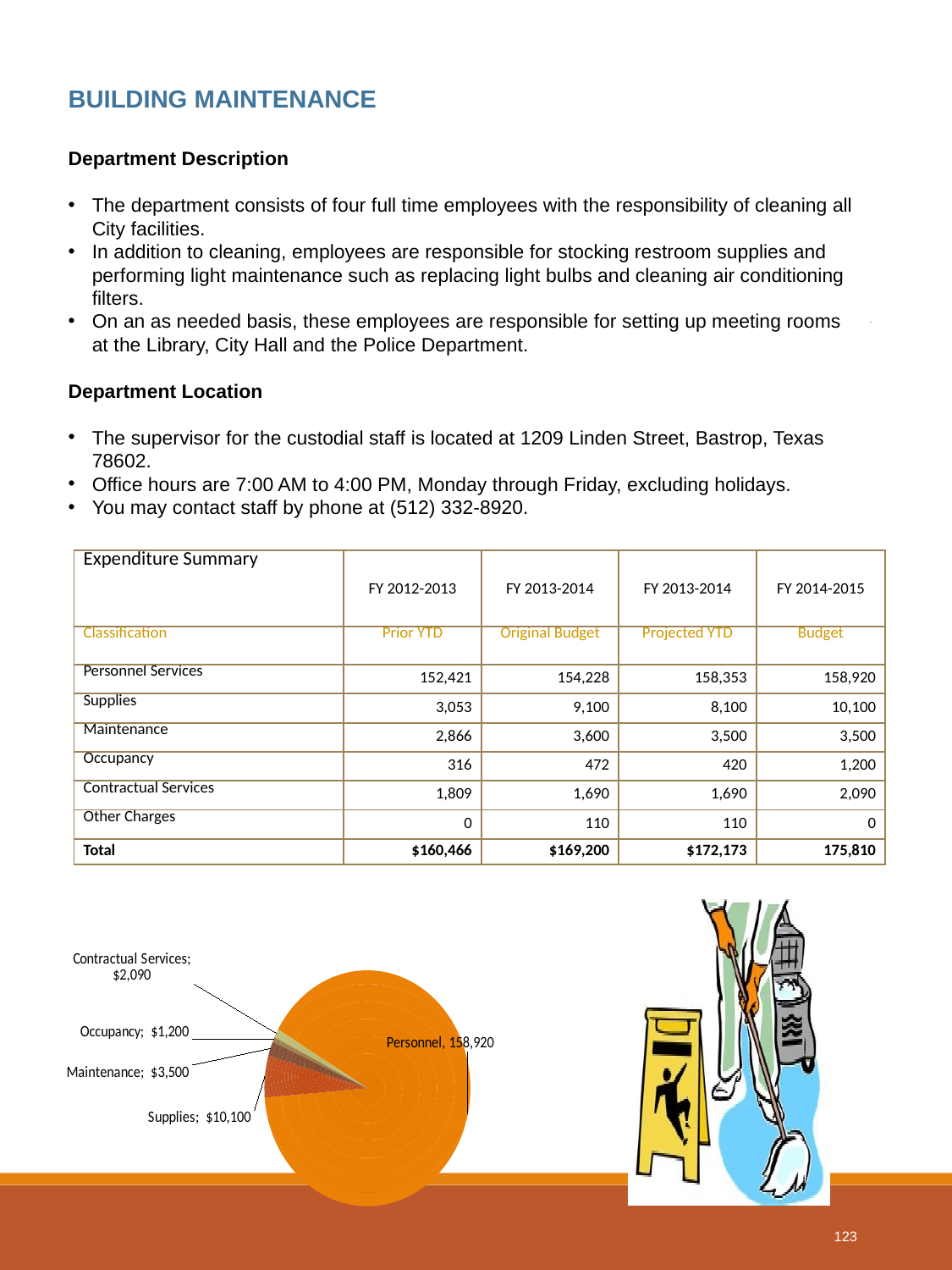
In the pie chart, what is the value for Personnel? 158,920 In the pie chart, what is the value for Occupancy? $1,200 In the pie chart, which is larger: Supplies or Maintenance? Supplies How many labelled slices does the pie chart have? 5 In the pie chart, what is the value for Contractual Services? $2,090 In the pie chart, what is the value for Maintenance? $3,500 Which labelled category has the smallest slice in the pie chart? Occupancy In the pie chart, what is the difference between the Supplies value and the Maintenance value? $6,600 What kind of chart is shown at the bottom of the slide? pie chart Which category has the largest slice in the pie chart? Personnel In the pie chart, what is the value for Supplies? $10,100 In the pie chart, what is the difference between the Contractual Services value and the Occupancy value? $890